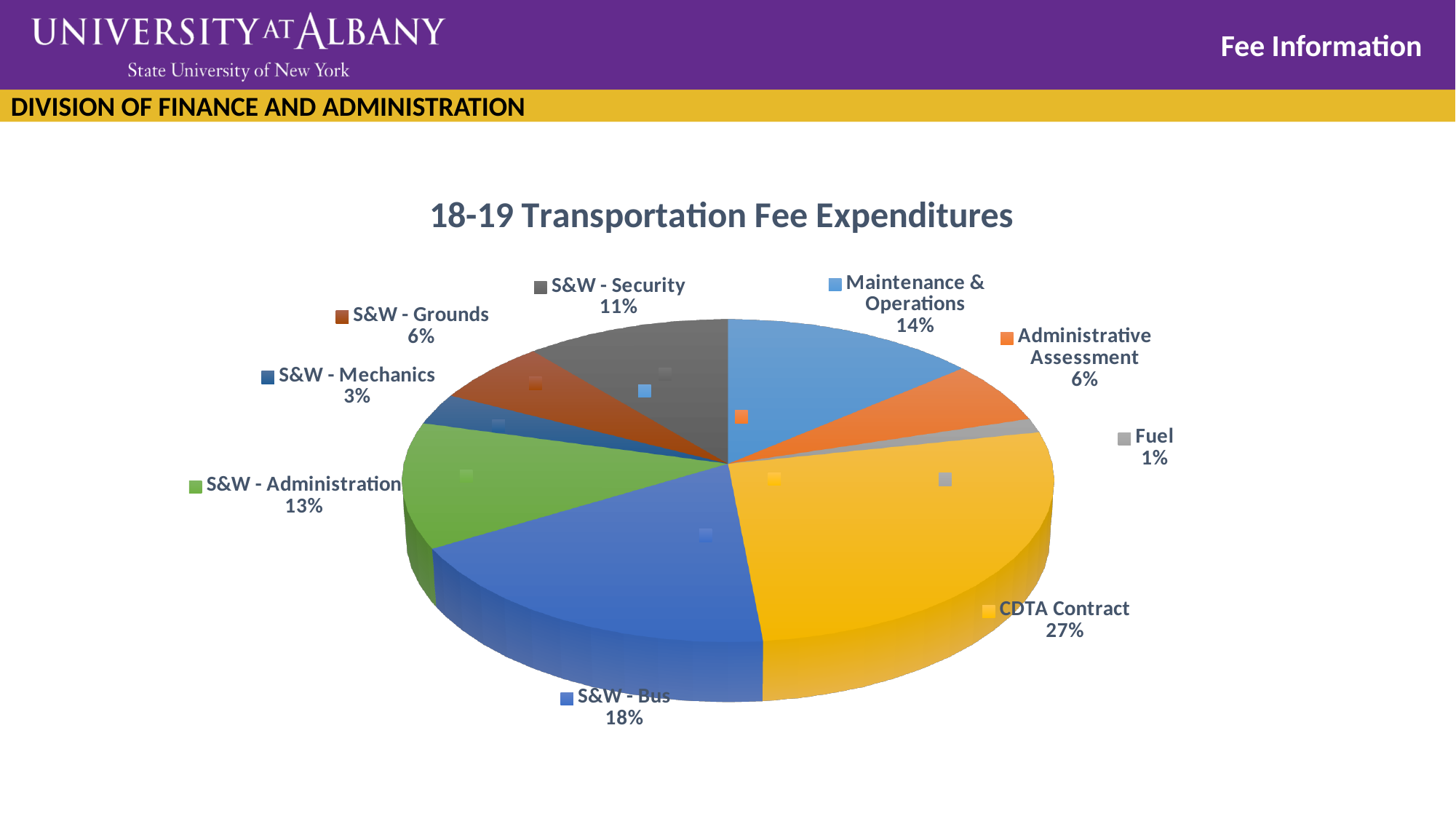
What is the title of the chart? 18-19 Transportation Fee Expenditures How many categories are shown in the pie chart? 9 Which category has the smallest share of the pie? Fuel What kind of chart is shown on the slide? Pie chart What percentage is shown for Maintenance & Operations? 14% What percentage is shown for S&W - Mechanics? 3% What percentage is shown for S&W - Bus? 18% What percentage is shown for Fuel? 1% Which is larger, S&W - Administration or S&W - Security? S&W - Administration Which category has the largest share of the pie? CDTA Contract What is the difference in percentage points between CDTA Contract and S&W - Bus? 9 What share of the pie does CDTA Contract represent? 27%